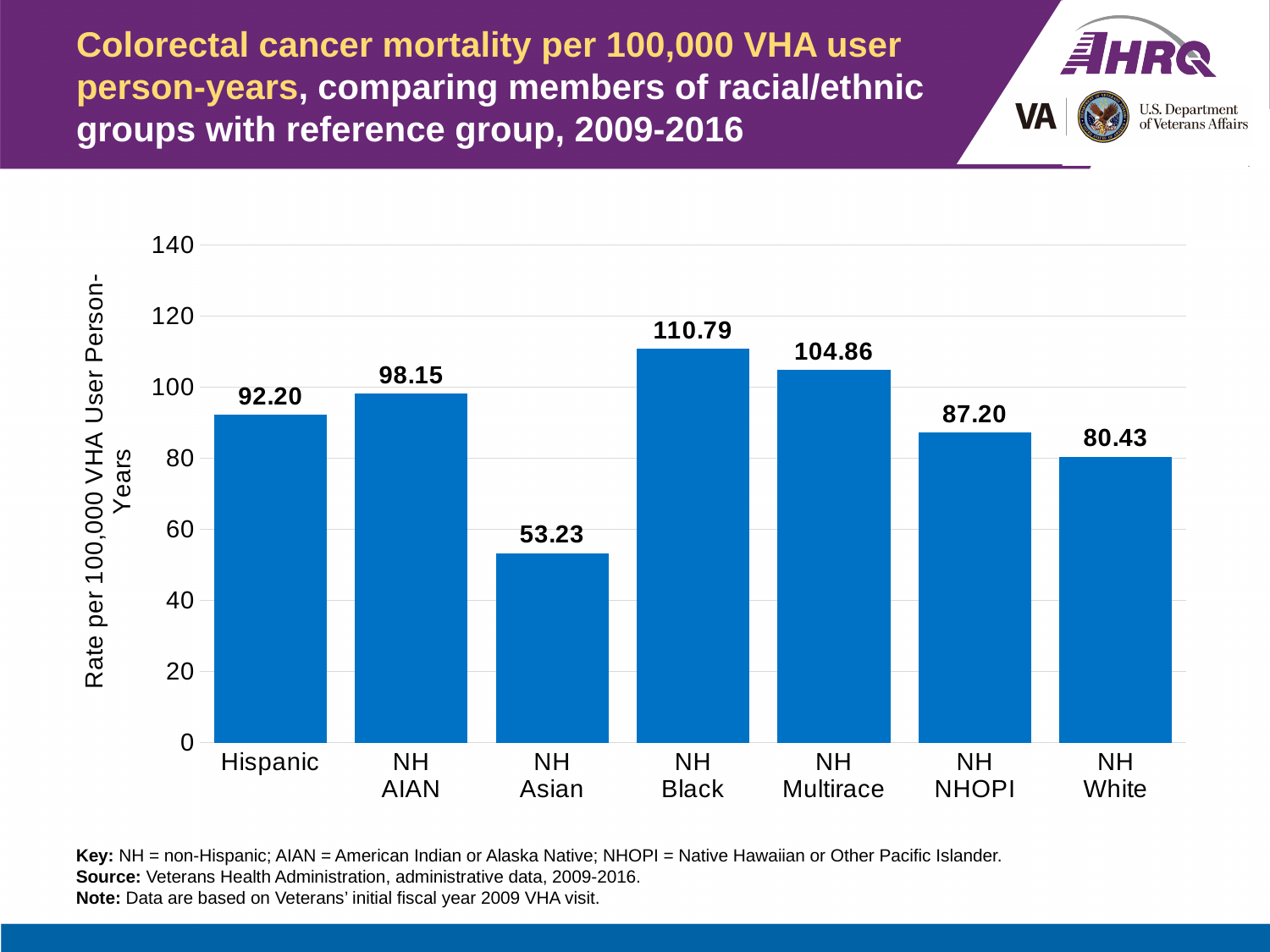
What is the difference between the rates for NH AIAN and NH NHOPI? 10.95 Which has a higher rate, NH Multirace or Hispanic? NH Multirace Which racial/ethnic group has the highest colorectal cancer mortality rate? NH Black What is the rate for Hispanic? 92.20 What is the rate for NH Asian? 53.23 What is the label of the vertical axis? Rate per 100,000 VHA User Person-Years Is the value for NH NHOPI greater or less than 100? less What kind of chart is shown on the slide? bar chart What is the difference between the rates for NH Black and NH White? 30.36 How many racial/ethnic groups are shown on the chart? 7 What is the colorectal cancer mortality rate per 100,000 VHA user person-years for NH Black? 110.79 Which racial/ethnic group has the lowest colorectal cancer mortality rate? NH Asian